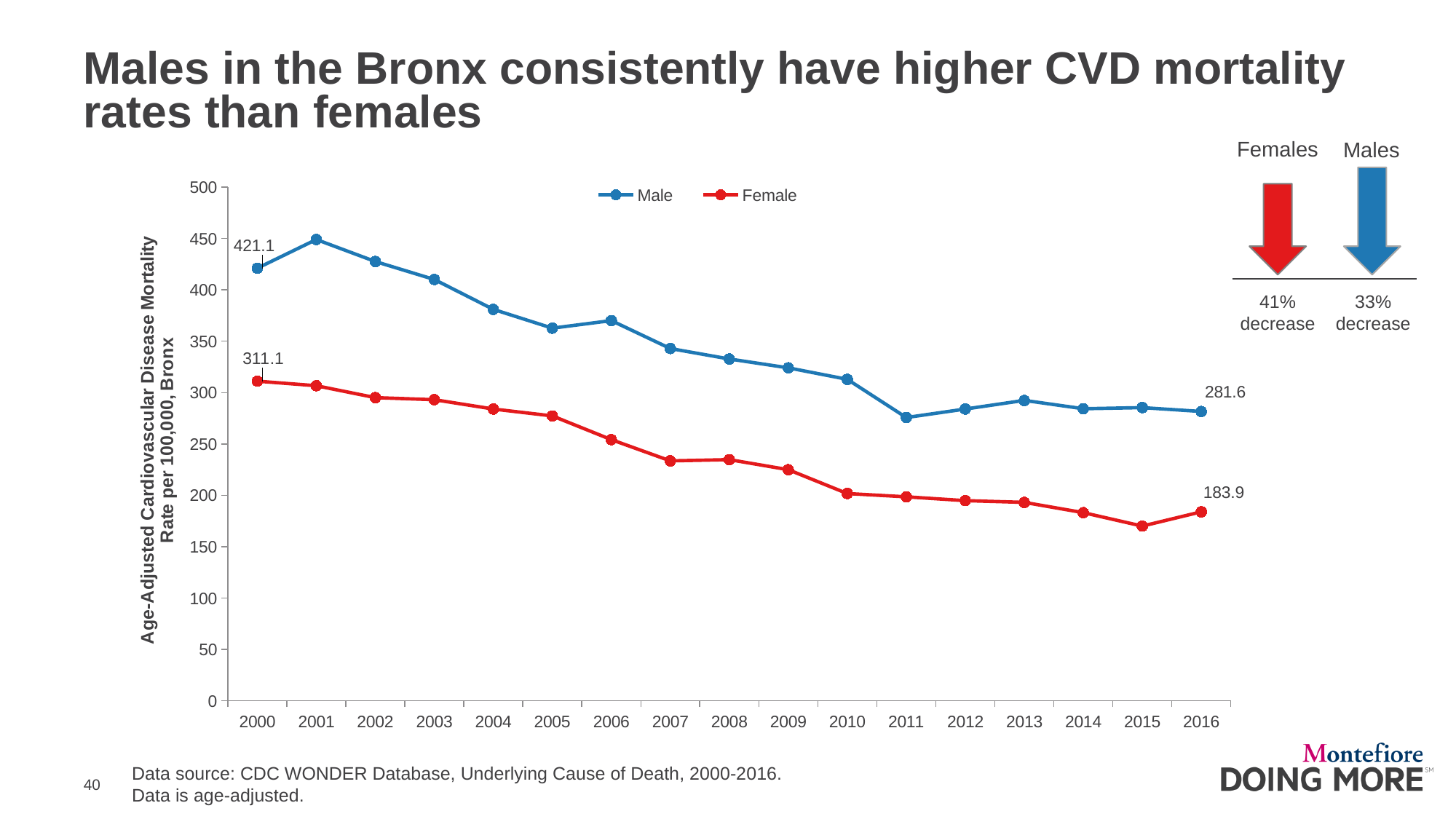
In which year is the male mortality rate highest? 2001 What is the male CVD mortality rate in 2000? 421.1 What is the female CVD mortality rate in 2016? 183.9 How many years are plotted on the x axis? 17 Which series has the higher value in 2016, Male or Female? Male Is the female mortality rate in 2015 greater or less than 200? less What is the female CVD mortality rate in 2000? 311.1 Is the male mortality rate in 2001 greater or less than 400? greater What is the male CVD mortality rate in 2016? 281.6 What is the difference between the male and female mortality rates in 2000? 110.0 By how much did the male mortality rate fall from 2000 to 2016? 139.5 How many series does the legend list? 2